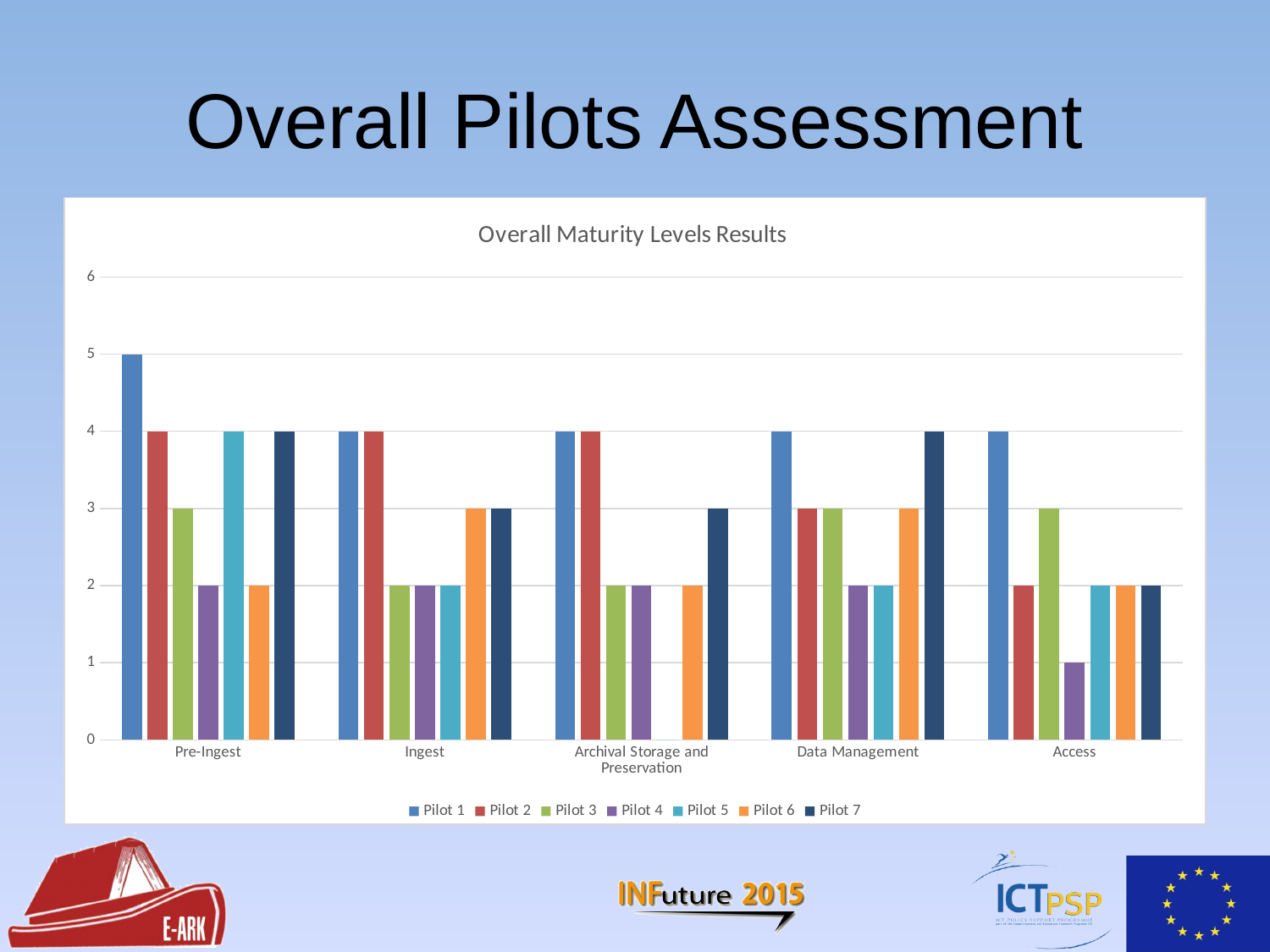
What is the value for Pilot 6 in the Ingest category? 3 How many series does the legend list? 7 What is the value for Pilot 4 in the Access category? 1 What is the value for Pilot 1 in the Pre-Ingest category? 5 Which pilot has the highest value in the Pre-Ingest category? Pilot 1 What is the difference between Pilot 1 and Pilot 3 in the Pre-Ingest category? 2 What is the title of the chart? Overall Maturity Levels Results Is the value for Pilot 1 in the Pre-Ingest category greater or less than 4? greater In the Data Management category, which is larger: Pilot 7 or Pilot 2? Pilot 7 What type of chart is shown on the slide? Bar chart How many categories are shown on the x axis? 5 Which pilot has the lowest value in the Access category? Pilot 4